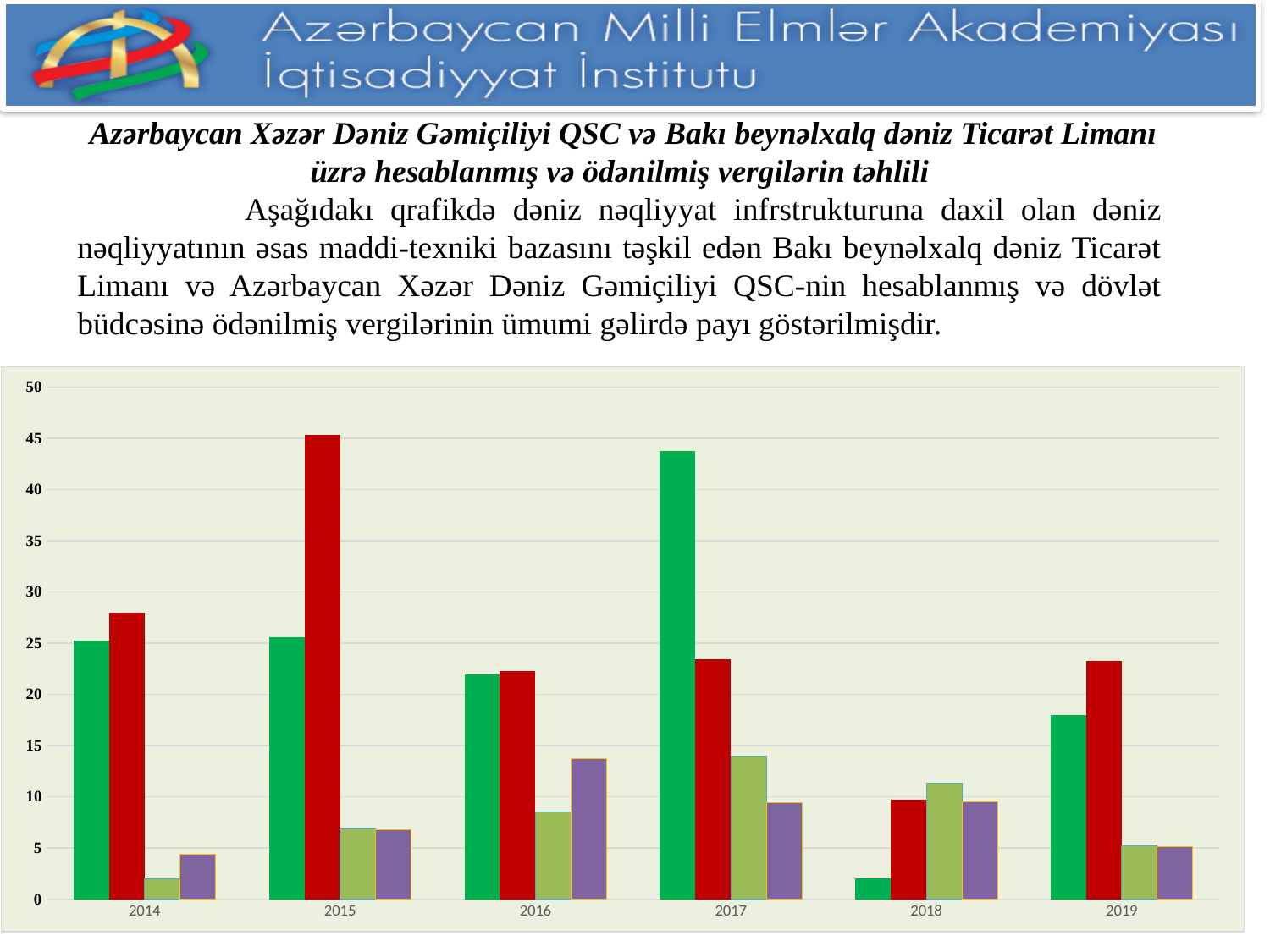
For 2018, which coloured bar is the tallest? the light green (olive) bar In which year is the purple bar the tallest? 2016 In which year is the red bar the tallest? 2015 For 2014, which is taller: the red bar or the green bar? the red bar Is the value of the green bar for 2017 greater or less than 40? greater How many years are shown on the x axis of the chart? 6 What kind of chart is shown on the slide? bar chart Is the value of the green bar for 2018 greater or less than 5? less In which year is the green bar the shortest? 2018 In which year is the green bar the tallest? 2017 Is the value of the red bar for 2015 greater or less than 40? greater How many bars are plotted for each year in the chart? 4